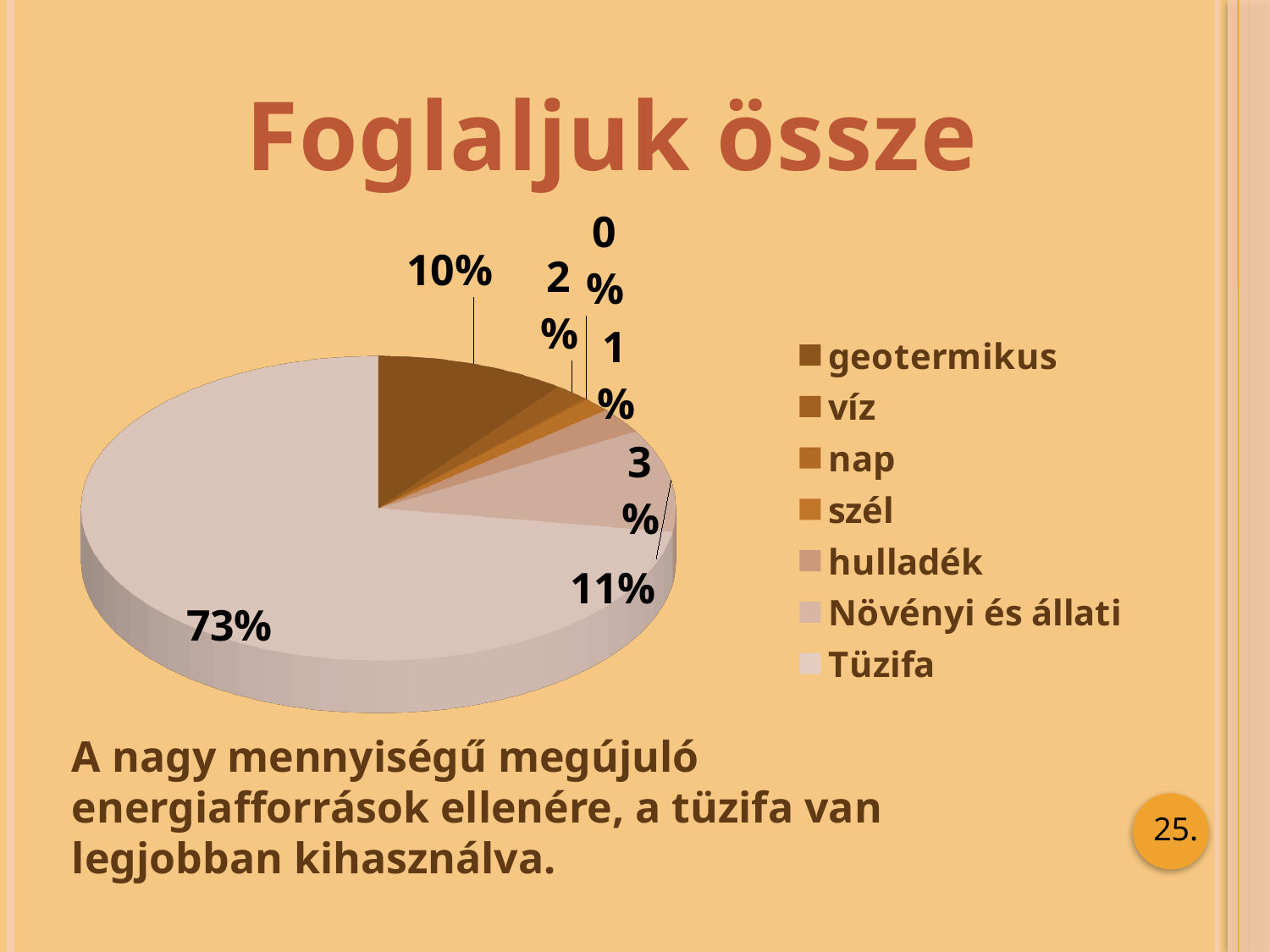
Which is larger, the share of geotermikus or the share of Növényi és állati? Növényi és állati What share of the pie does hulladék have? 3% What share of the pie does Tüzifa have? 73% What kind of chart is shown on the slide? pie chart How many categories does the legend of the pie chart list? 7 Which legend entry is listed first in the pie chart's legend? geotermikus Which category has the smallest slice of the pie? nap Which category has the largest slice of the pie? Tüzifa What share of the pie does Növényi és állati have? 11% What is the title of the slide containing the pie chart? Foglaljuk össze What is the difference between the shares of Tüzifa and Növényi és állati? 62%